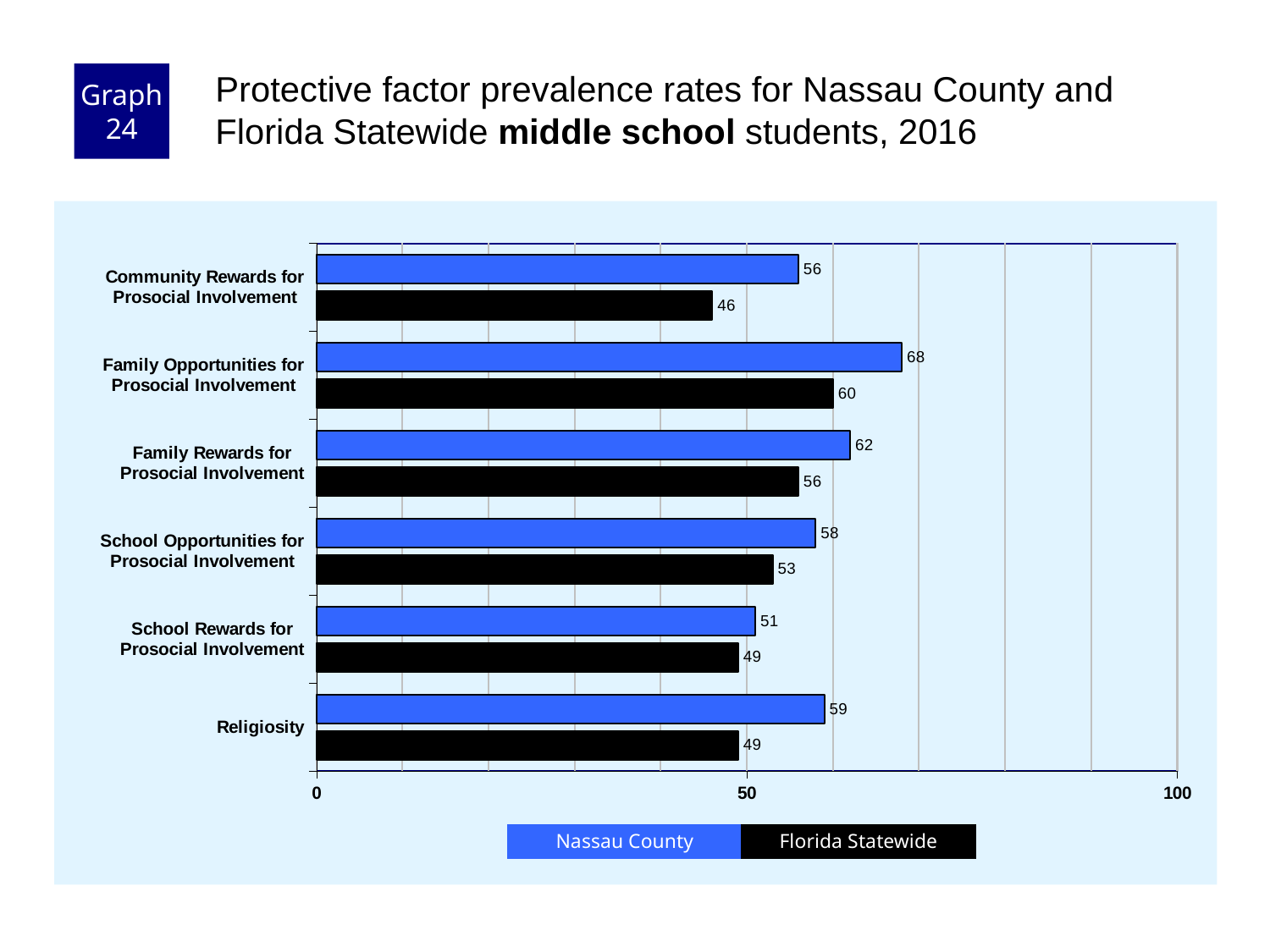
How many series does the legend list? 2 Is the Florida Statewide value for Family Opportunities for Prosocial Involvement greater or less than 50? greater What is the Florida Statewide value for Religiosity? 49 What kind of chart is shown on the slide? bar chart Which protective factor has the highest Nassau County value? Family Opportunities for Prosocial Involvement Which is larger for School Opportunities for Prosocial Involvement: the Nassau County value or the Florida Statewide value? Nassau County Which series is shown in black? Florida Statewide What is the Florida Statewide value for Community Rewards for Prosocial Involvement? 46 How many protective factors are shown on the chart? 6 What is the Nassau County value for Family Opportunities for Prosocial Involvement? 68 What is the difference between the Nassau County and Florida Statewide values for Religiosity? 10 Which protective factor has the lowest Florida Statewide value? Community Rewards for Prosocial Involvement